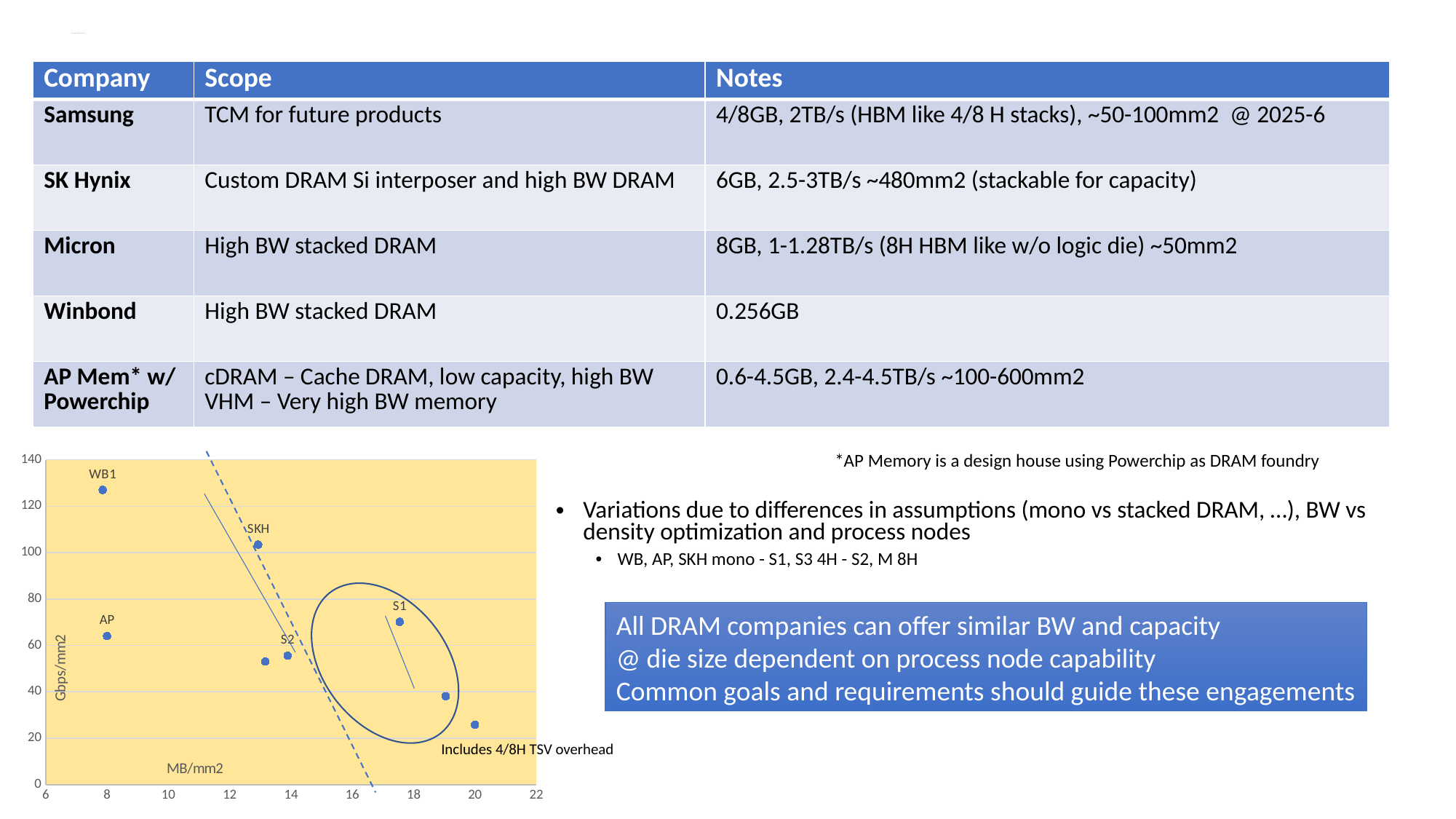
Is the Gbps/mm2 value for WB1 greater or less than 120? greater Is the MB/mm2 value for S1 greater or less than 16? greater Which has the higher Gbps/mm2 value, SKH or S2? SKH Is the Gbps/mm2 value for SKH greater or less than 80? greater What is the label of the vertical axis of the scatter chart? Gbps/mm2 What kind of chart is shown at the bottom left of the slide? scatter chart What is the label of the horizontal axis of the scatter chart? MB/mm2 Which has the higher Gbps/mm2 value, WB1 or AP? WB1 Which labeled point has the highest Gbps/mm2 value in the scatter chart? WB1